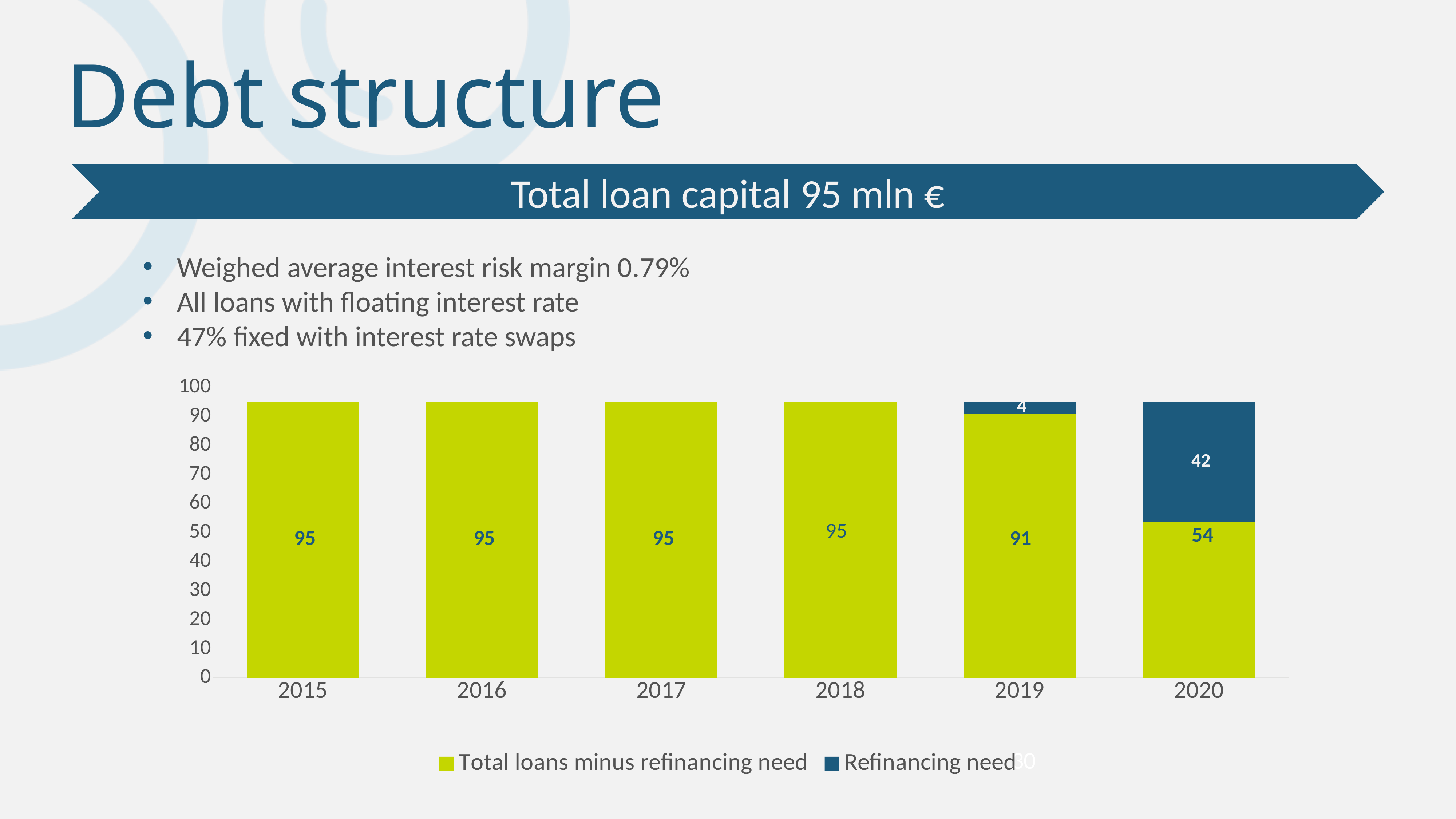
What is the total of the stacked bar for 2020? 96 What is the value of "Refinancing need" for 2020? 42 Which year has the lowest value for "Total loans minus refinancing need"? 2020 Is the "Total loans minus refinancing need" value for 2020 larger or smaller than the value for 2019? smaller What is the difference between the "Refinancing need" values for 2020 and 2019? 38 Which year has the highest value for "Refinancing need"? 2020 How many series does the chart legend list? 2 What is the value of "Total loans minus refinancing need" for 2019? 91 What is the value of "Refinancing need" for 2019? 4 What is the value of "Total loans minus refinancing need" for 2015? 95 How many years are shown on the x axis of the chart? 6 What type of chart is shown on the slide? stacked bar chart